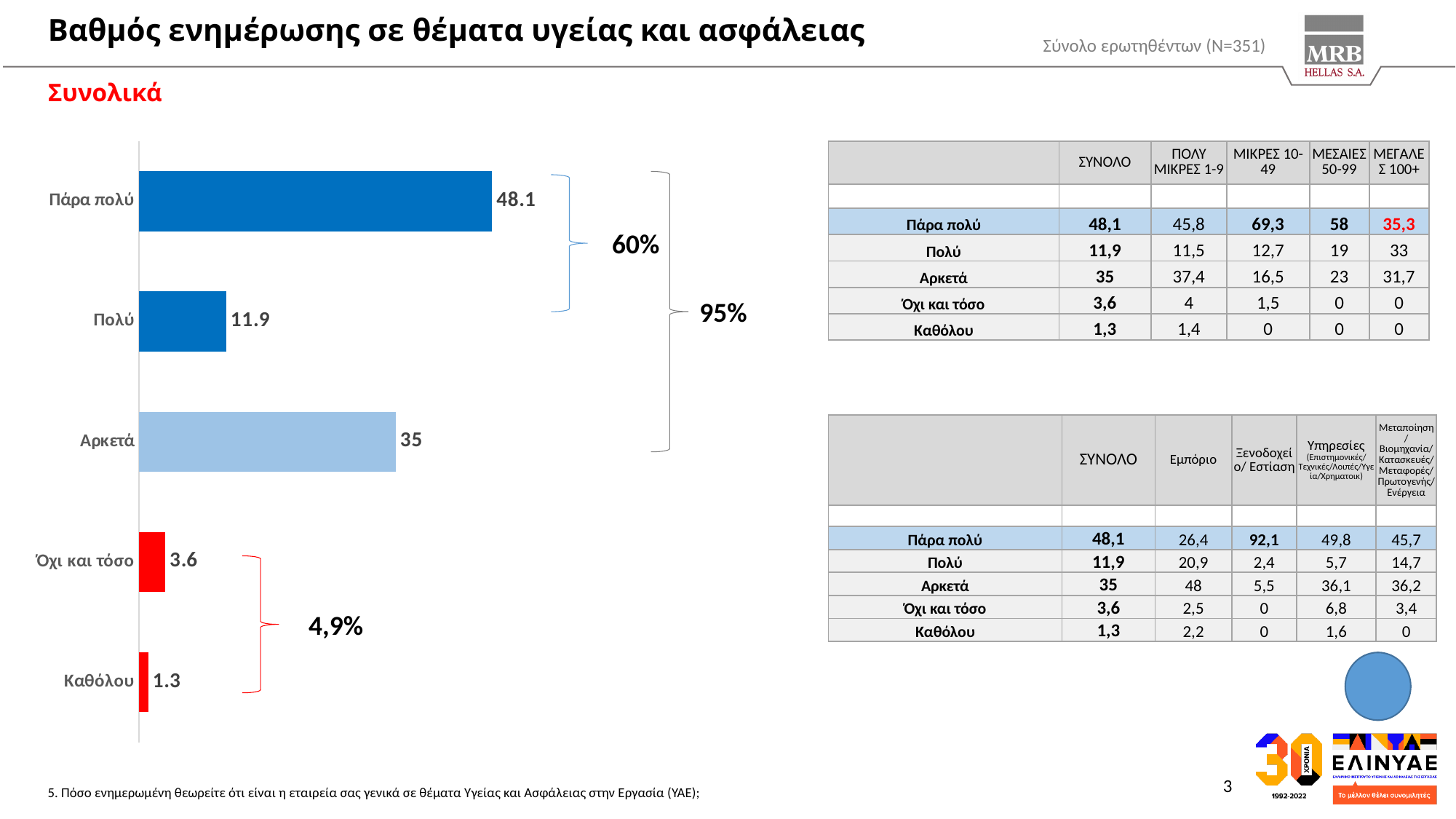
Which category has the highest value in the bar chart? Πάρα πολύ What colour are the bars for Όχι και τόσο and Καθόλου in the bar chart? Red What is the value for Αρκετά in the bar chart? 35 Which category has the lowest value in the bar chart? Καθόλου What is the value for Πάρα πολύ in the bar chart? 48.1 What kind of chart is shown on the left of the slide? Bar chart What is the combined value of Όχι και τόσο and Καθόλου in the bar chart? 4.9 What is the value for Όχι και τόσο in the bar chart? 3.6 How many categories are shown in the bar chart? 5 What is the value for Καθόλου in the bar chart? 1.3 Which is larger in the bar chart, the value for Πολύ or the value for Αρκετά? Αρκετά What is the difference between the values for Πάρα πολύ and Αρκετά in the bar chart? 13.1